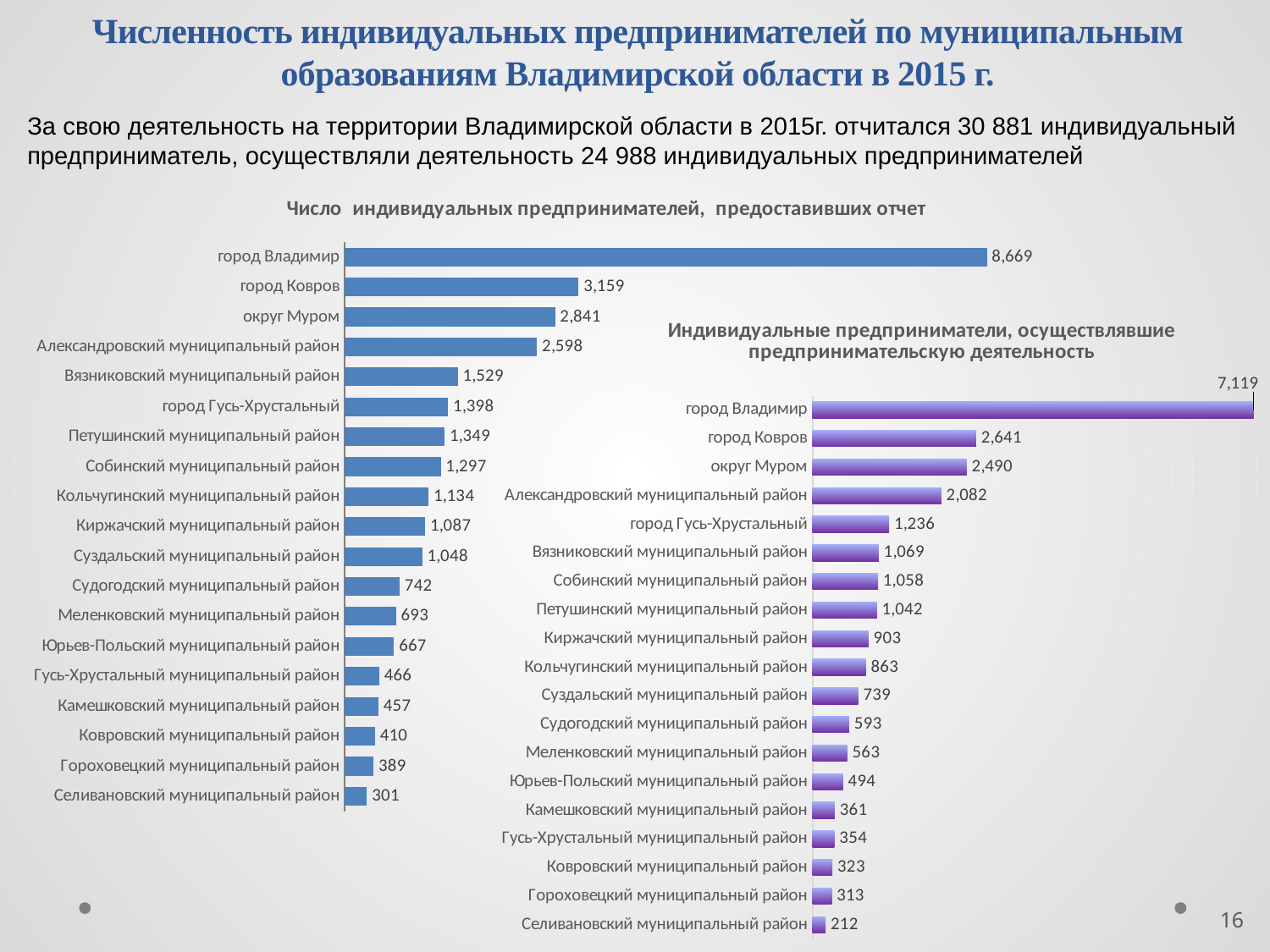
In the chart titled "Число индивидуальных предпринимателей, предоставивших отчет", what is the difference between город Ковров and округ Муром? 318 How many categories are shown in the chart titled "Индивидуальные предприниматели, осуществлявшие предпринимательскую деятельность"? 19 In the chart titled "Индивидуальные предприниматели, осуществлявшие предпринимательскую деятельность", which category has the highest value? город Владимир In the chart titled "Индивидуальные предприниматели, осуществлявшие предпринимательскую деятельность", what is the value for Юрьев-Польский муниципальный район? 494 In the chart titled "Число индивидуальных предпринимателей, предоставивших отчет", what is the value for Кольчугинский муниципальный район? 1,134 What type of chart is the chart titled "Число индивидуальных предпринимателей, предоставивших отчет"? Bar chart In the chart titled "Индивидуальные предприниматели, осуществлявшие предпринимательскую деятельность", what is the value for округ Муром? 2,490 In the chart titled "Число индивидуальных предпринимателей, предоставивших отчет", which is larger: Судогодский муниципальный район or Меленковский муниципальный район? Судогодский муниципальный район In the chart titled "Число индивидуальных предпринимателей, предоставивших отчет", what is the value for город Владимир? 8,669 In the chart titled "Число индивидуальных предпринимателей, предоставивших отчет", which category has the lowest value? Селивановский муниципальный район In the chart titled "Индивидуальные предприниматели, осуществлявшие предпринимательскую деятельность", what is the difference between город Владимир and город Ковров? 4,478 What colour are the bars in the chart titled "Индивидуальные предприниматели, осуществлявшие предпринимательскую деятельность"? Purple